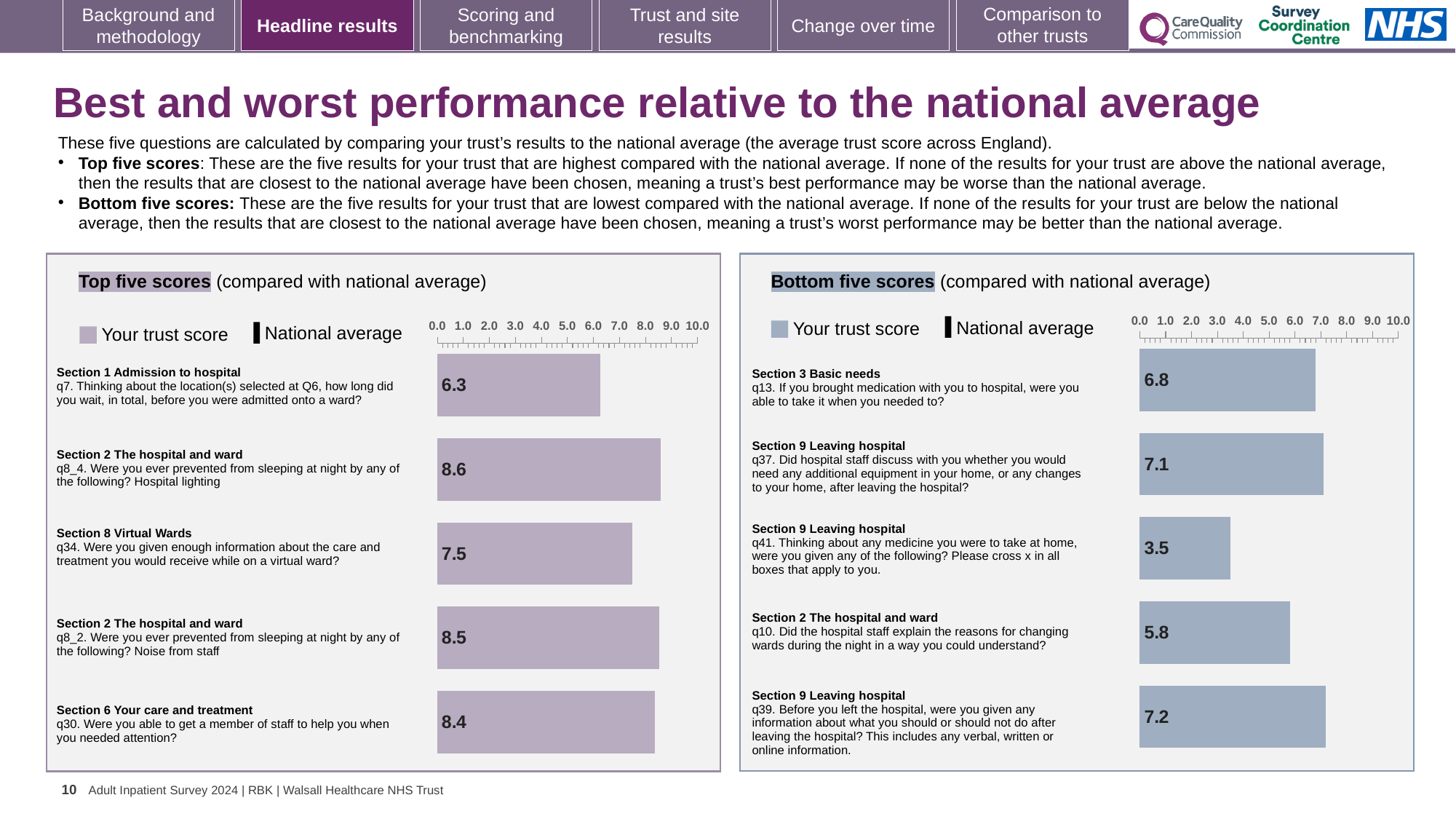
In the Bottom five scores chart, is the trust score for q41 greater or less than 4.0? less In the Bottom five scores chart, which question has the highest trust score? q39 (information before leaving hospital) In the Bottom five scores chart, what is the trust score for q41 (medicine you were to take at home)? 3.5 In the Top five scores chart, what is the difference between the trust scores for q8_4 and q7? 2.3 In the Bottom five scores chart, which question has the lowest trust score? q41 (medicine to take at home) In the Bottom five scores chart, what is the difference between the trust scores for q39 and q41? 3.7 What kind of chart is used in the Bottom five scores panel? Bar chart In the Bottom five scores chart, which has the larger trust score, q13 or q10? q13 How many questions are plotted in the Top five scores chart? 5 In the Top five scores chart, which question has the highest trust score? q8_4 (Hospital lighting) In the Top five scores chart, what is the trust score for q7 (how long did you wait before being admitted onto a ward)? 6.3 In the Top five scores chart, which question has the lowest trust score? q7 (wait before admitted onto a ward)